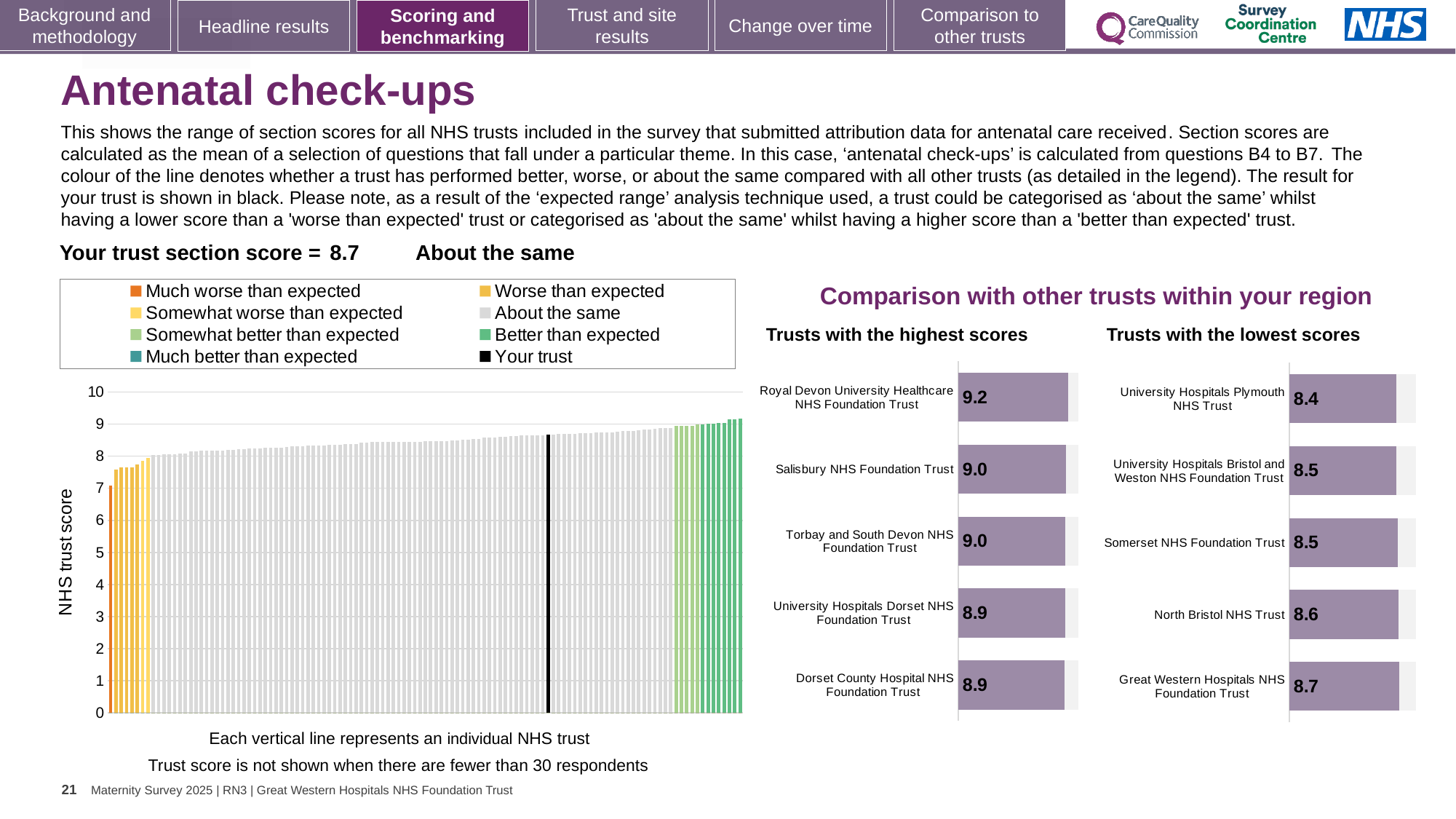
In the 'Trusts with the lowest scores' chart, which trust has the lowest score? University Hospitals Plymouth NHS Trust In the 'Trusts with the highest scores' chart, what is the score for Royal Devon University Healthcare NHS Foundation Trust? 9.2 In the 'Trusts with the lowest scores' chart, what is the score for University Hospitals Plymouth NHS Trust? 8.4 How many entries does the legend of the large chart on the left list? 8 In the 'Trusts with the highest scores' chart, what is the difference between the scores of Royal Devon University Healthcare NHS Foundation Trust and Dorset County Hospital NHS Foundation Trust? 0.3 In the 'Trusts with the highest scores' chart, what is the score for University Hospitals Dorset NHS Foundation Trust? 8.9 In the 'Trusts with the highest scores' chart, which trust has the highest score? Royal Devon University Healthcare NHS Foundation Trust In the 'Trusts with the lowest scores' chart, what is the difference between the scores of Great Western Hospitals NHS Foundation Trust and University Hospitals Plymouth NHS Trust? 0.3 In the large chart on the left, is the value for the black bar representing your trust greater or less than 8? greater What kind of chart is the large chart on the left showing NHS trust scores? Bar chart How many trusts are listed in the 'Trusts with the lowest scores' chart? 5 In the 'Trusts with the lowest scores' chart, which has the higher score: North Bristol NHS Trust or Somerset NHS Foundation Trust? North Bristol NHS Trust